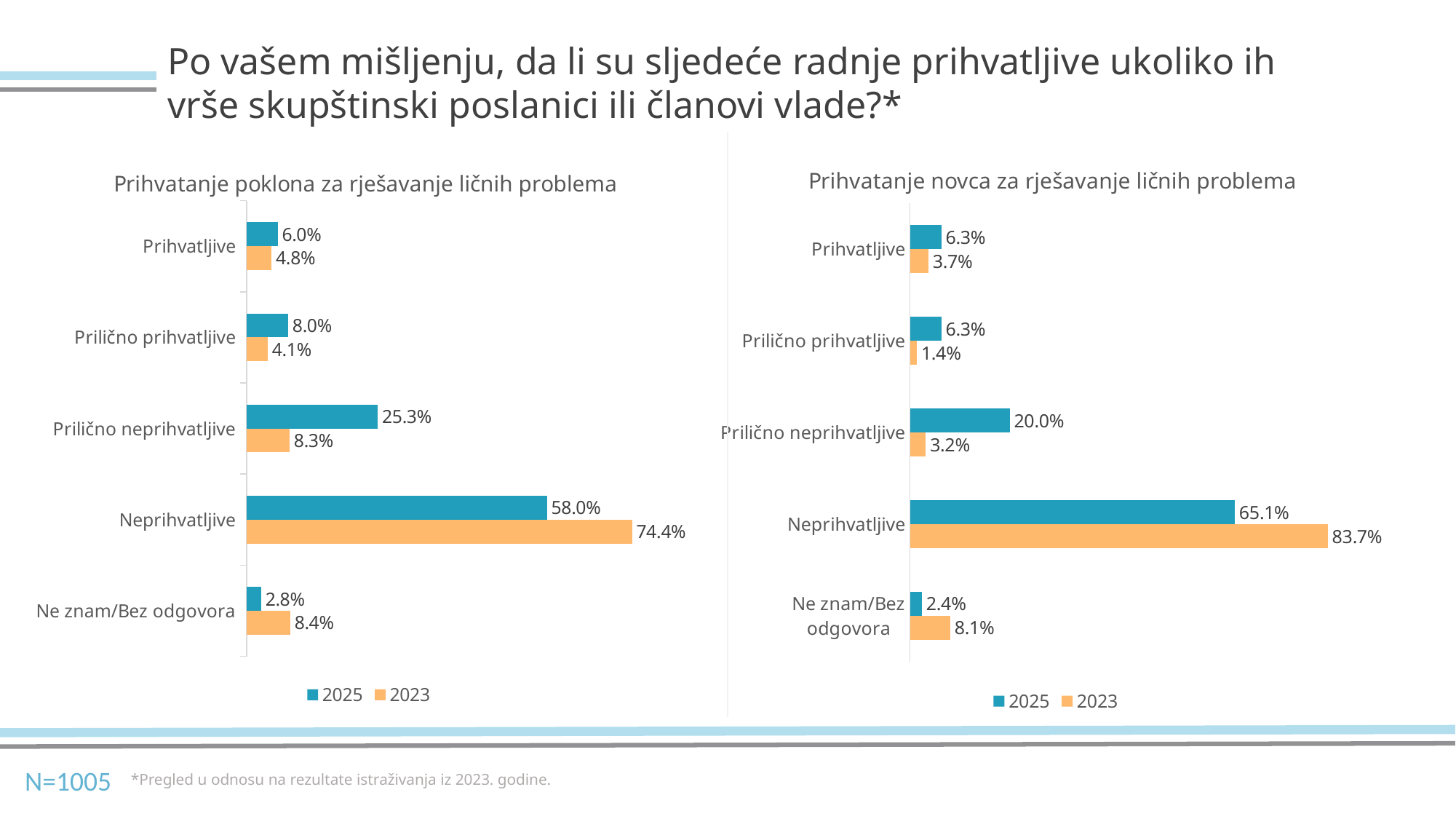
In the chart 'Prihvatanje poklona za rješavanje ličnih problema', what is the 2023 value for 'Prilično neprihvatljive'? 8.3% How many series does the legend list in the chart 'Prihvatanje poklona za rješavanje ličnih problema'? 2 How many categories are shown in the chart 'Prihvatanje novca za rješavanje ličnih problema'? 5 In the chart 'Prihvatanje poklona za rješavanje ličnih problema', what is the 2025 value for 'Neprihvatljive'? 58.0% In the chart 'Prihvatanje novca za rješavanje ličnih problema', which category has the lowest 2023 value? Prilično prihvatljive In the chart 'Prihvatanje poklona za rješavanje ličnih problema', which is larger for 'Ne znam/Bez odgovora': the 2025 value or the 2023 value? 2023 In the chart 'Prihvatanje novca za rješavanje ličnih problema', what is the 2023 value for 'Neprihvatljive'? 83.7% In the chart 'Prihvatanje novca za rješavanje ličnih problema', what is the difference between the 2025 and 2023 values for 'Prilično neprihvatljive'? 16.8% What type of chart is 'Prihvatanje novca za rješavanje ličnih problema'? Bar chart In the chart 'Prihvatanje novca za rješavanje ličnih problema', what is the 2023 value for 'Prilično prihvatljive'? 1.4% In the chart 'Prihvatanje poklona za rješavanje ličnih problema', what is the difference between the 2023 and 2025 values for 'Neprihvatljive'? 16.4% In the chart 'Prihvatanje poklona za rješavanje ličnih problema', which category has the highest 2025 value? Neprihvatljive